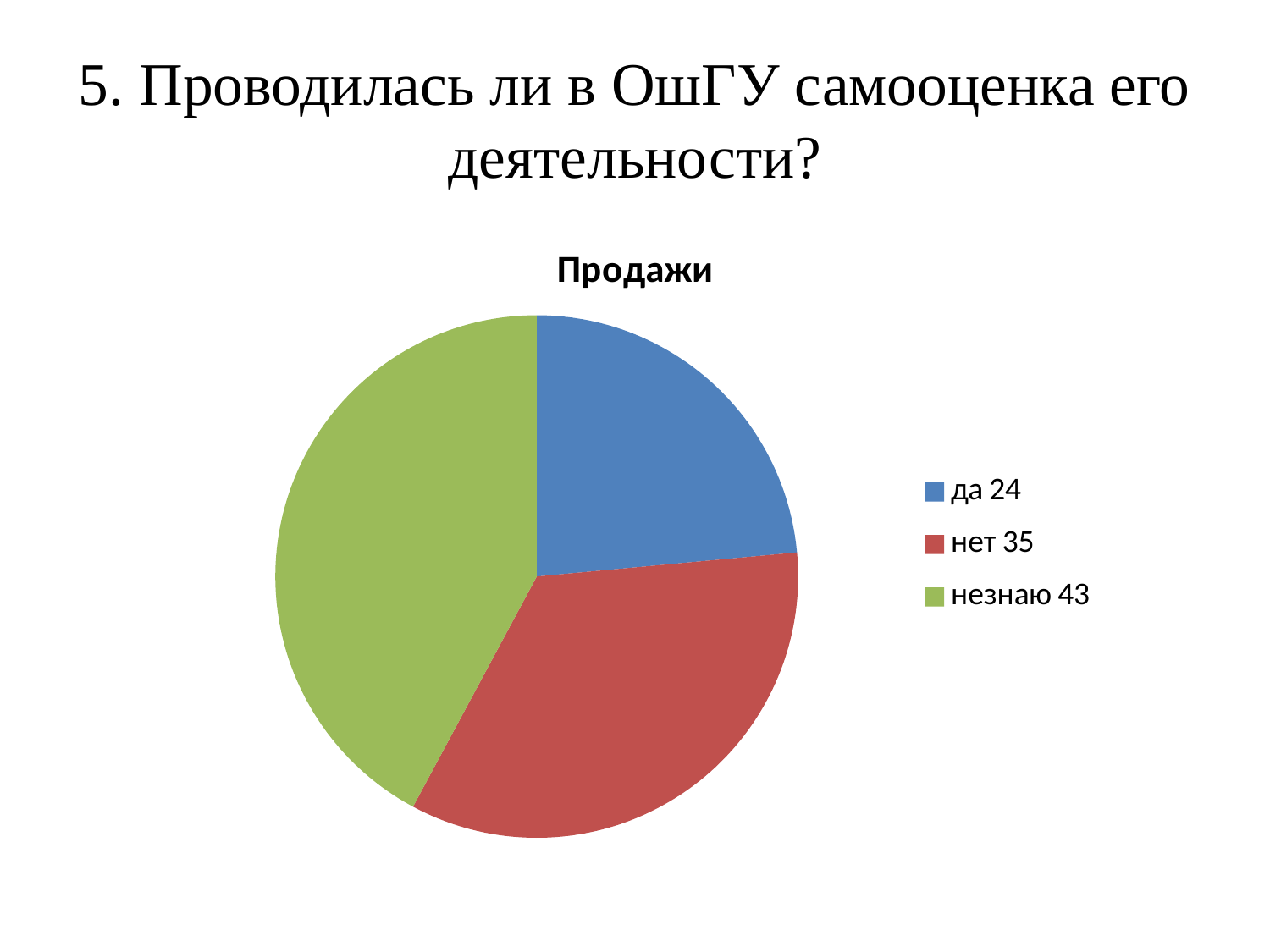
What is the title of the chart? Продажи How many slices does the pie chart have? 3 What value is shown for 'нет' in the legend? 35 How many entries does the legend list? 3 What kind of chart is shown on the slide? pie chart Which category has the largest slice of the pie? незнаю What value is shown for 'да' in the legend? 24 What is the difference between the values for 'незнаю' and 'да'? 19 What colour is the slice for 'незнаю'? green What value is shown for 'незнаю' in the legend? 43 Which category has the smallest slice of the pie? да Which is larger, the value for 'нет' or the value for 'да'? нет